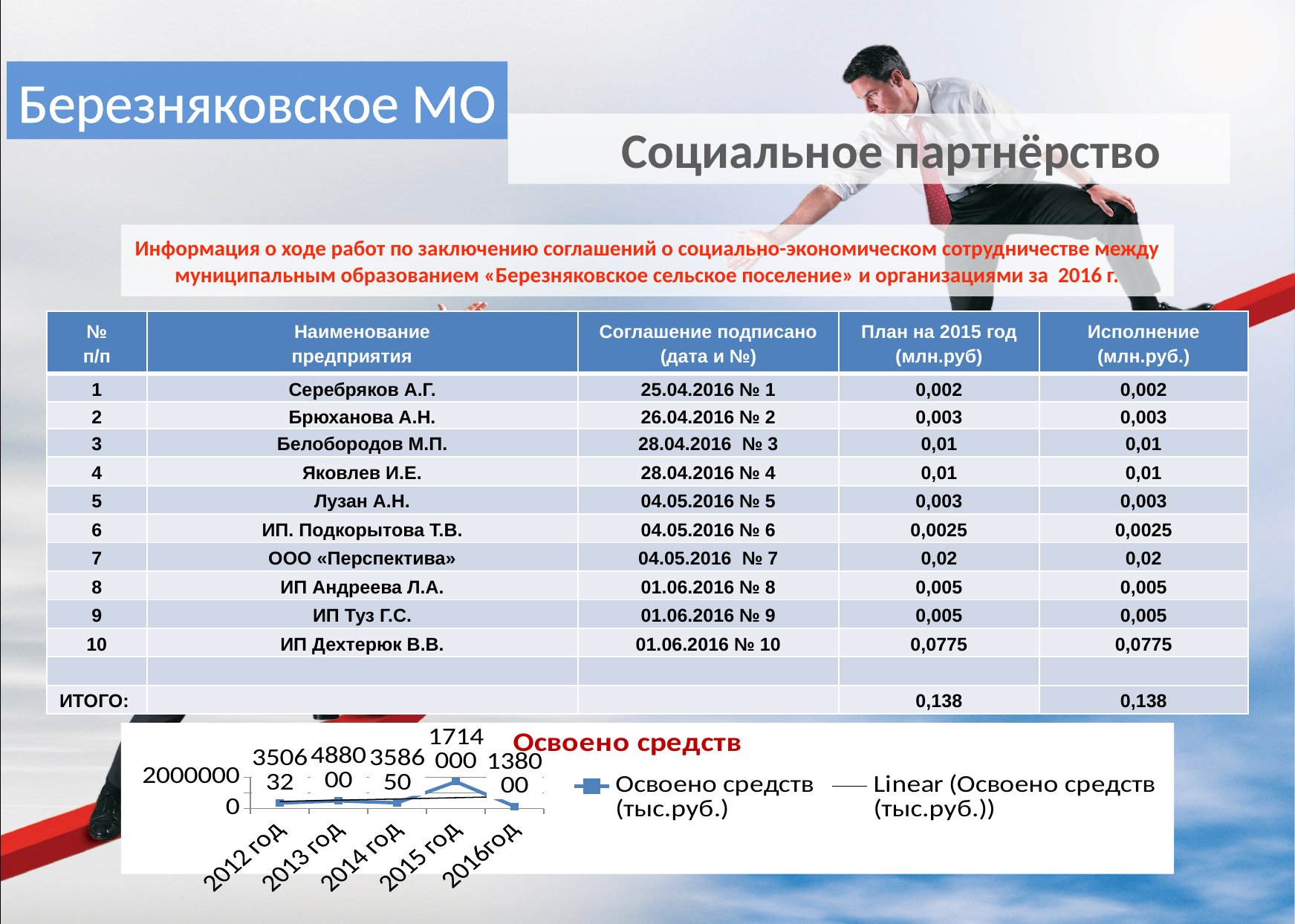
How many years are plotted along the x axis of the chart? 5 What is the title of the chart at the bottom of the slide? Освоено средств What kind of chart is shown at the bottom of the slide? line chart Which year has the lowest value in the chart? 2016год How many entries does the legend of the chart list? 2 What is the value for 2013 год in the chart? 488000 What is the value for 2016год in the chart? 138000 What is the value for 2015 год in the chart? 1714000 What is the difference between the values for 2015 год and 2016год in the chart? 1576000 Which is larger in the chart, the value for 2013 год or the value for 2014 год? 2013 год Which year has the highest value in the chart? 2015 год What is the value for 2012 год in the chart? 350632